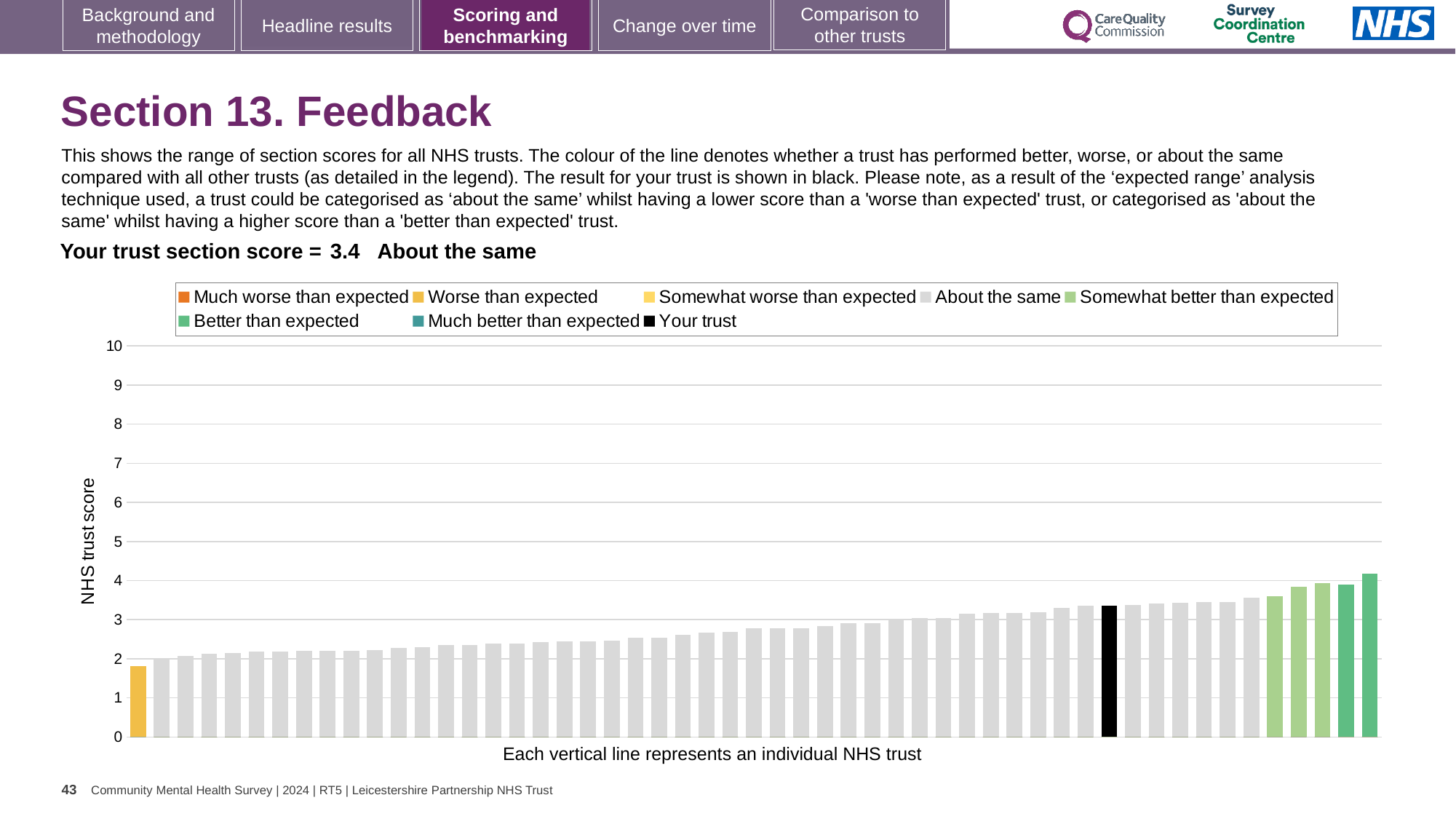
Is the value of the leftmost (yellow) bar greater or less than 2? less What colour is used for the bar representing your trust? Black What is the highest value shown on the vertical axis? 10 What kind of chart is shown on the slide? Bar chart Is the value of the black bar (your trust) greater or less than 4? less Is the value of the tallest bar greater or less than 5? less What is the section score for your trust shown on the slide? 3.4 How is your trust categorised compared with other trusts for this section? About the same How many entries does the chart legend list? 8 What is the label on the vertical axis of the chart? NHS trust score Do the bar values rise or fall from left to right along the x axis? Rise